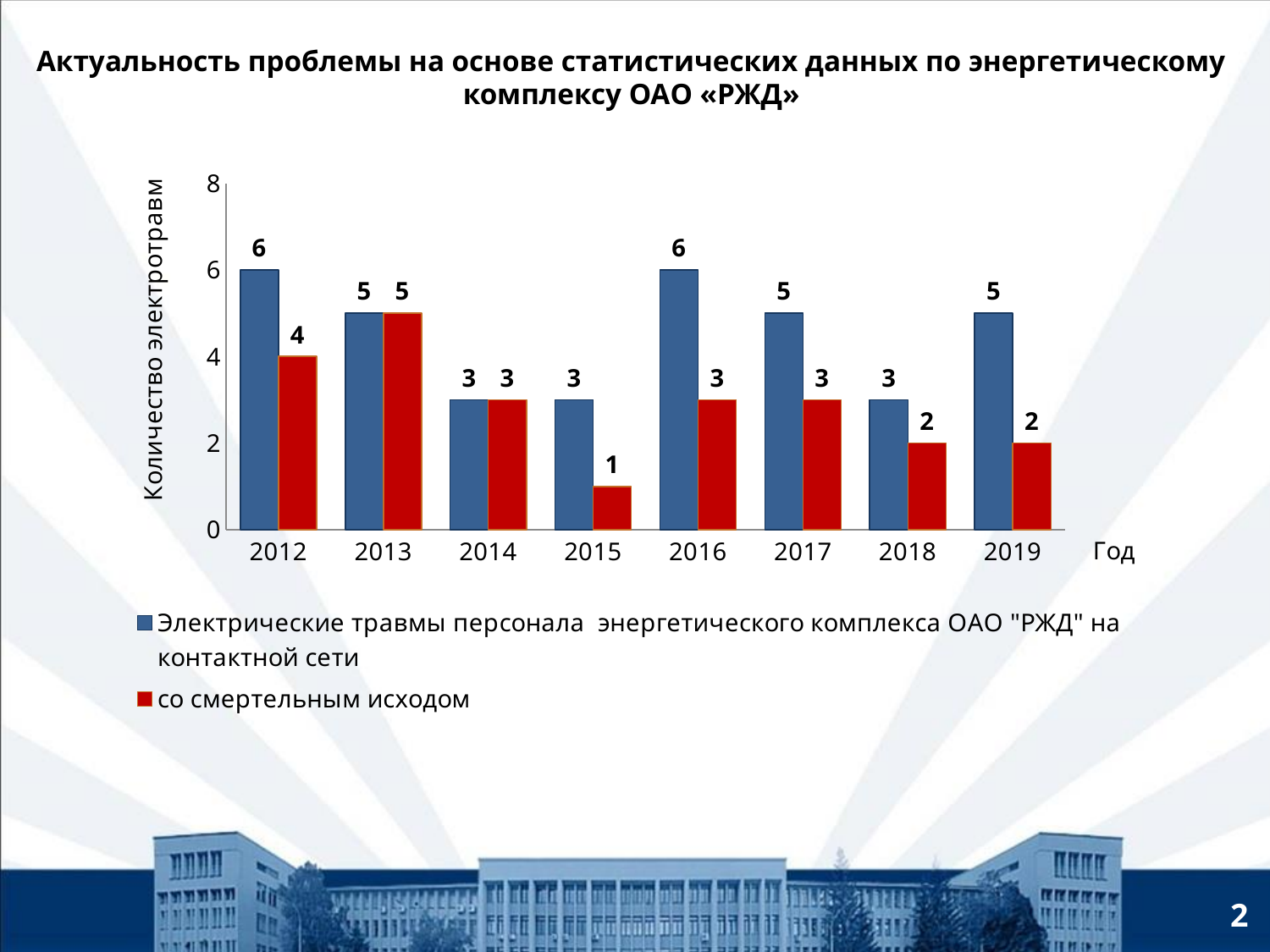
In which year is the red series (со смертельным исходом) lowest? 2015 In which year is the red series (со смертельным исходом) highest? 2013 What is the difference between the blue and red values in 2015? 2 How many series does the legend list? 2 How many years are shown on the x axis? 8 What type of chart is shown on the slide? Bar chart What is the value of the red series (со смертельным исходом) for 2012? 4 What is the value of the blue series (Электрические травмы персонала) for 2016? 6 What is the value of the red series (со смертельным исходом) for 2015? 1 What is the label of the y axis? Количество электротравм What is the difference between the blue series values for 2016 and 2018? 3 Which is larger in 2019: the blue series or the red series? The blue series